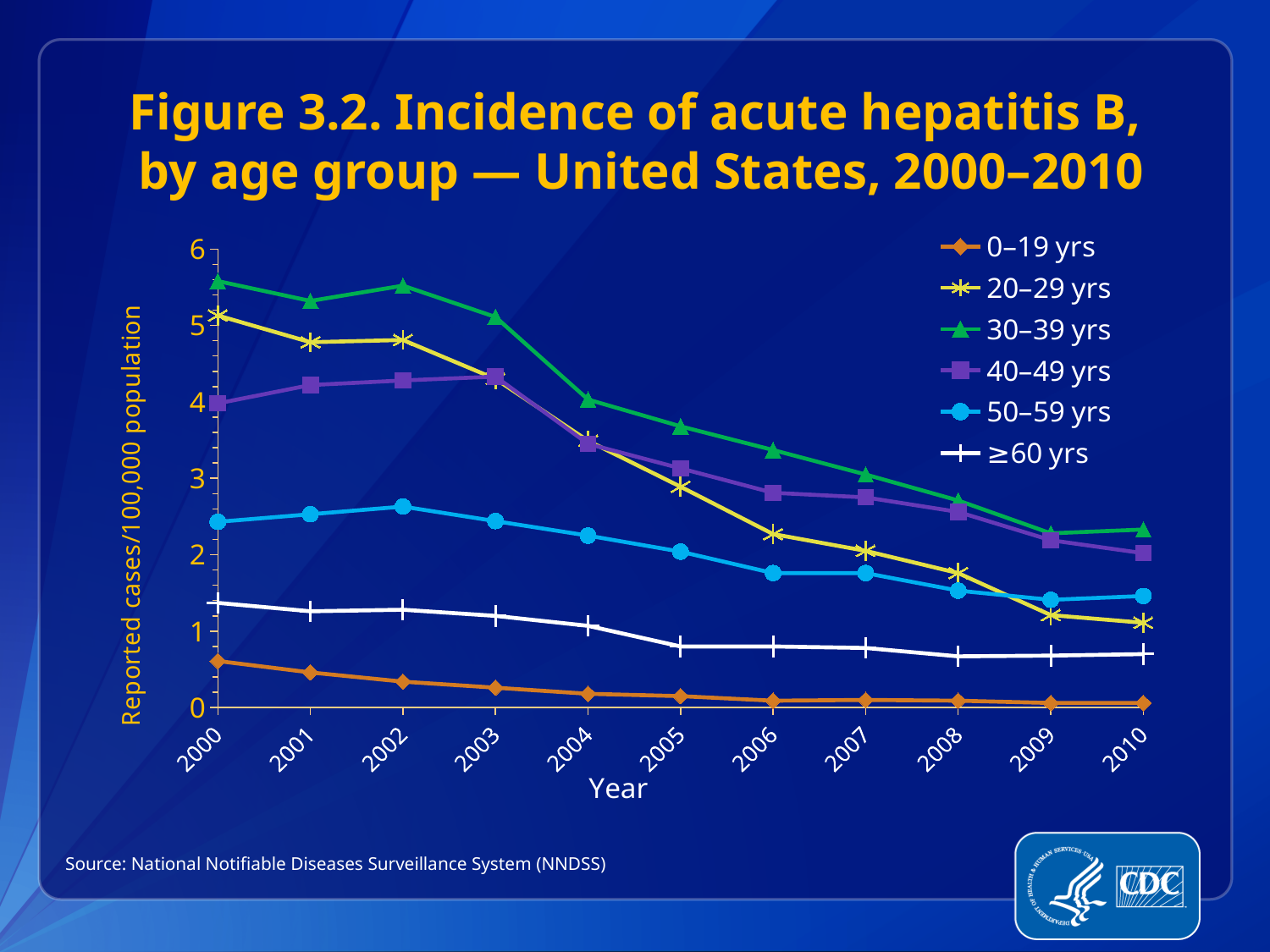
How many years are plotted along the x axis? 11 Which age group had the highest incidence in 2000? 30–39 yrs Is the value for 30–39 yrs in 2000 greater or less than 5? greater How many age groups does the legend list? 6 What kind of chart is shown on the slide? line chart Is the value for 0–19 yrs in 2000 greater or less than 1? less What is the label on the y axis? Reported cases/100,000 population Which age group had the lowest incidence in 2010? 0–19 yrs Is the value for ≥60 yrs in 2010 greater or less than 1? less In 2005, which had the higher incidence: 30–39 yrs or 40–49 yrs? 30–39 yrs Does the incidence for 20–29 yrs rise or fall from 2000 to 2010? fall